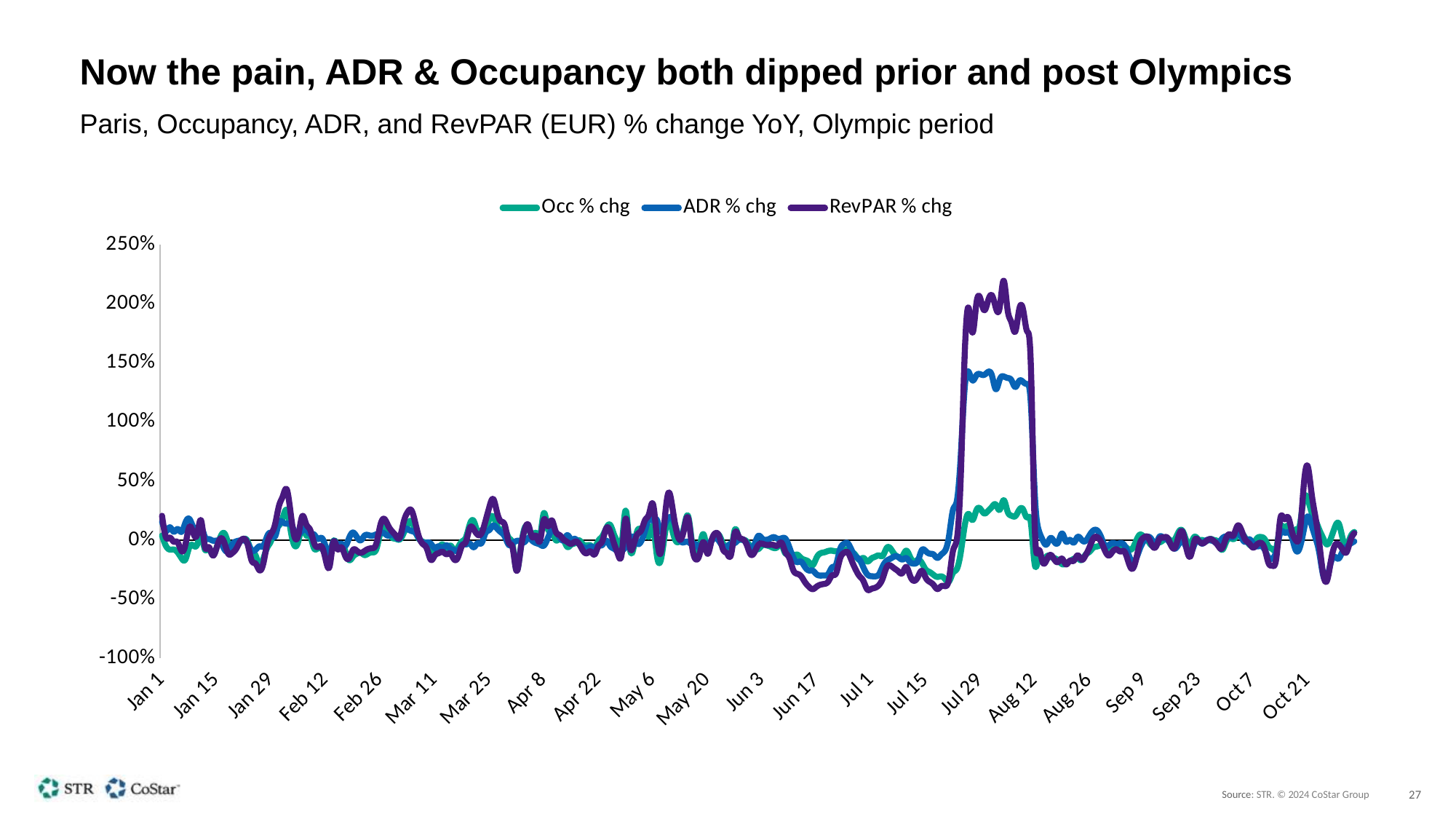
Is the value of RevPAR % chg around Jun 17 greater or less than 0%? less Is the peak value of RevPAR % chg during the Olympic period (around Jul 29 to Aug 12) greater or less than 200%? greater How many series does the legend list? 3 Which series has the lowest values during the Olympic period (around Jul 29 to Aug 12)? Occ % chg What kind of chart is shown on the slide? Line chart Is the value of Occ % chg during the Olympic period (around Jul 29 to Aug 12) greater or less than 50%? less During the Olympic period (around Jul 29 to Aug 12), which is larger: ADR % chg or Occ % chg? ADR % chg Which series reaches the highest value during the Olympic period (around Jul 29 to Aug 12)? RevPAR % chg What are the three series named in the legend? Occ % chg, ADR % chg, RevPAR % chg What is the subtitle of the chart? Paris, Occupancy, ADR, and RevPAR (EUR) % change YoY, Olympic period